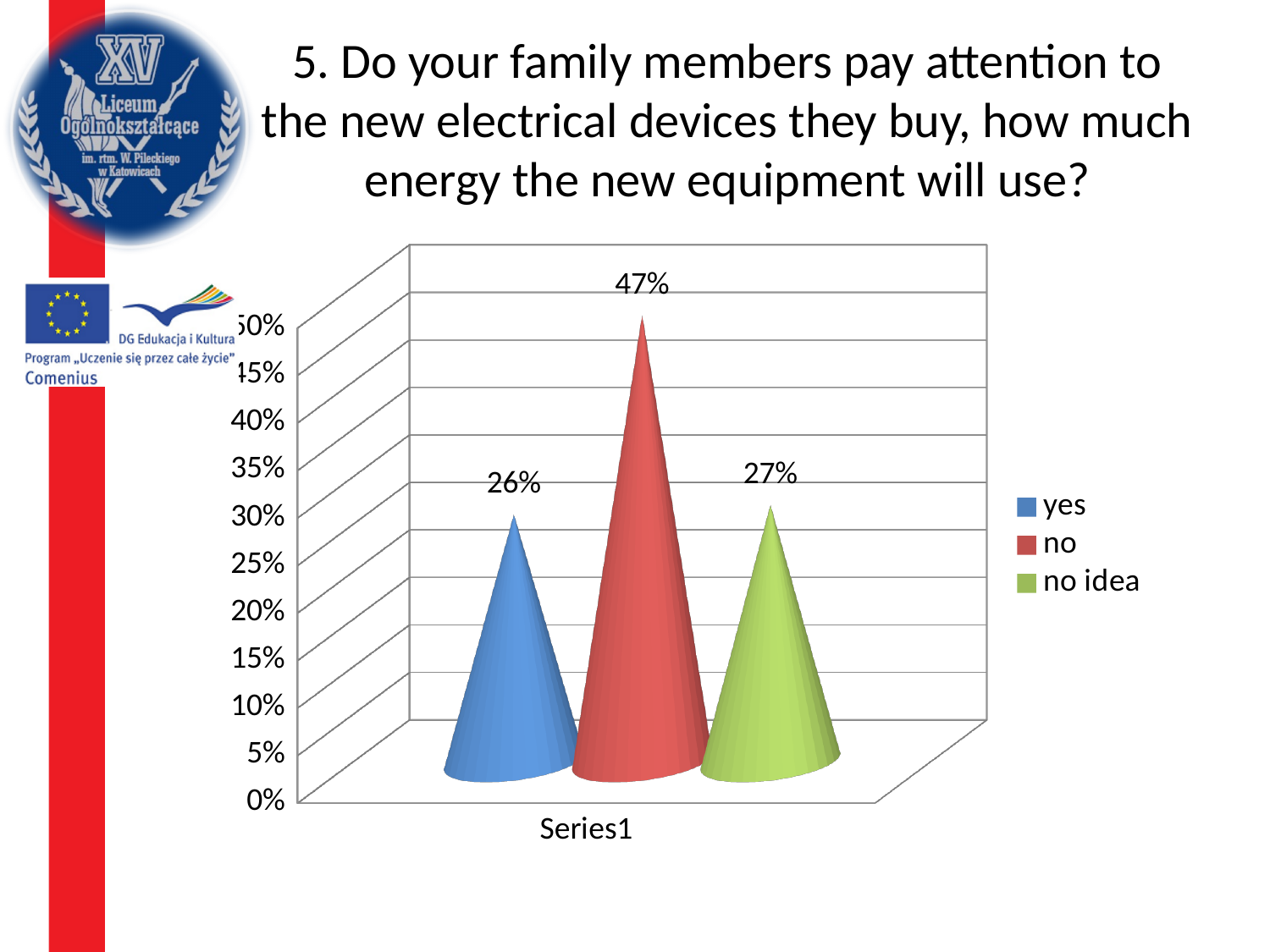
Which is larger, the value for "no" or the value for "no idea"? no How many entries does the legend list? 3 What percentage of respondents answered "no idea"? 27% What is the difference in percentage points between "no" and "yes"? 21 Which answer has the highest percentage? no Is the value for "no" greater or less than 40%? greater How many answer categories are shown in the chart? 3 What kind of chart is shown on the slide? bar chart Which answer has the lowest percentage? yes What percentage of respondents answered "no"? 47% What percentage of respondents answered "yes"? 26% What is the difference in percentage points between "no" and "no idea"? 20